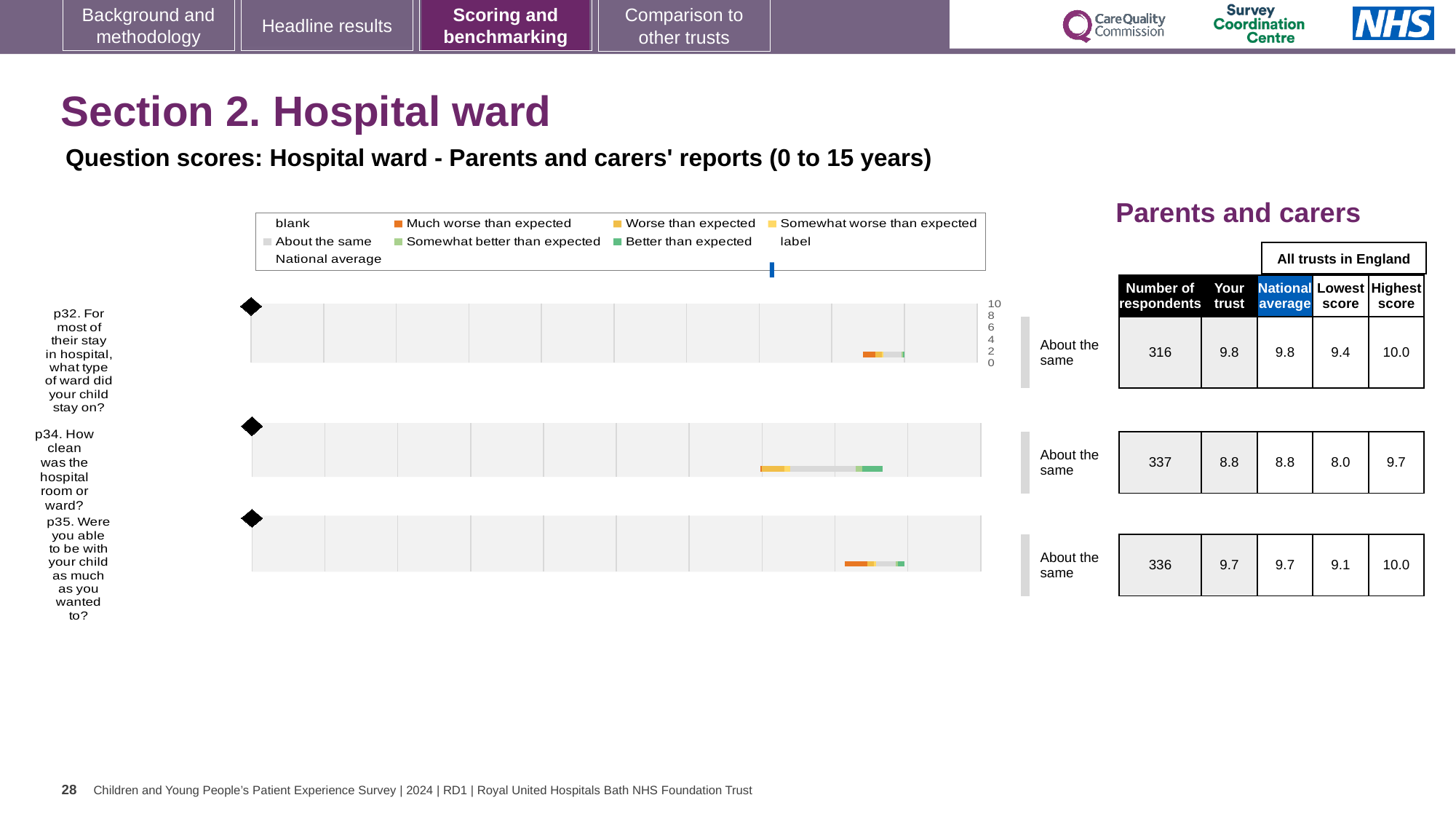
What kind of chart is used to show the question scores? Bar chart What is the national average for p34? 8.8 Which question has the highest 'Your trust' score? p32 Which colour in the legend represents 'Much worse than expected'? Orange What benchmark category is shown for p35 (Were you able to be with your child as much as you wanted to?)? About the same Which question has the lowest 'Your trust' score? p34 Which is larger: the lowest score for p32 or the lowest score for p35? p32 (9.4) How many respondents answered p32 (what type of ward did your child stay on)? 316 What is the highest score across all trusts in England for p35? 10.0 For p34, what is the difference between the highest score and the lowest score across all trusts in England? 1.7 What is the 'Your trust' score for p34 (How clean was the hospital room or ward?)? 8.8 How many survey questions are plotted on the slide? 3